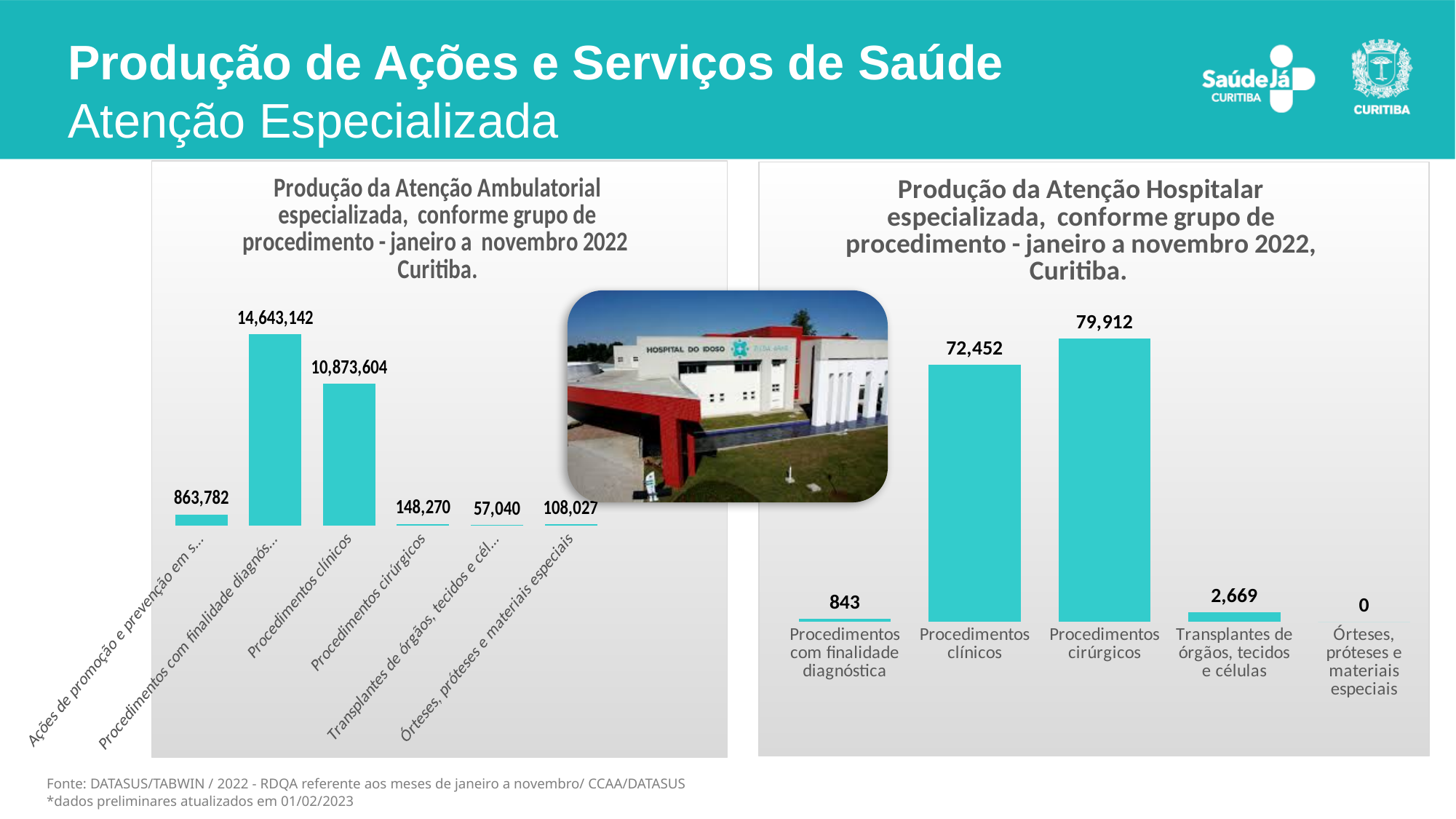
In the 'Produção da Atenção Hospitalar especializada' chart, which category has the highest value? Procedimentos cirúrgicos In the 'Produção da Atenção Hospitalar especializada' chart, what is the difference between Procedimentos cirúrgicos and Procedimentos clínicos? 7,460 In the 'Produção da Atenção Hospitalar especializada' chart, what is the value for Procedimentos clínicos? 72,452 How many categories are shown in the 'Produção da Atenção Hospitalar especializada' chart? 5 In the 'Produção da Atenção Hospitalar especializada' chart, what is the value for Procedimentos cirúrgicos? 79,912 What type of chart is the 'Produção da Atenção Ambulatorial especializada' chart? Bar chart In the 'Produção da Atenção Ambulatorial especializada' chart, what is the highest value shown? 14,643,142 In the 'Produção da Atenção Ambulatorial especializada' chart, what is the value for Procedimentos cirúrgicos? 148,270 In the 'Produção da Atenção Hospitalar especializada' chart, what is the value for Transplantes de órgãos, tecidos e células? 2,669 In the 'Produção da Atenção Ambulatorial especializada' chart, what is the value for Órteses, próteses e materiais especiais? 108,027 In the 'Produção da Atenção Ambulatorial especializada' chart, what is the value for Procedimentos clínicos? 10,873,604 In the 'Produção da Atenção Hospitalar especializada' chart, which category has the lowest value? Órteses, próteses e materiais especiais